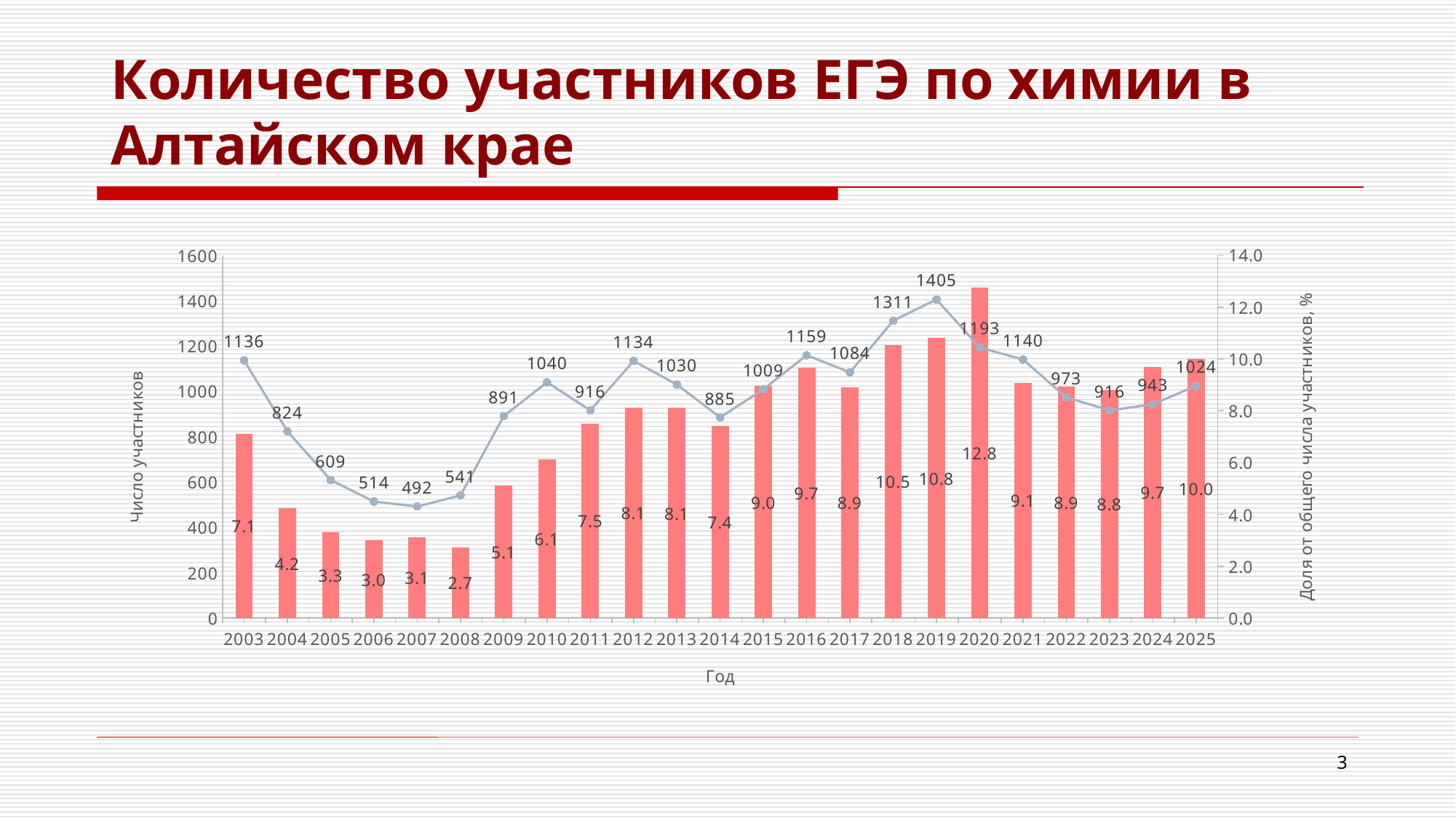
What is the number of participants shown for 2003? 1136 Does the number of participants rise or fall from 2003 to 2007? Fall Which year has the lowest share of the total number of participants? 2008 How many years are shown on the x axis of the chart? 23 Which year had more participants, 2012 or 2013? 2012 How many participants took the chemistry exam in 2019 according to the chart? 1405 Which year has the lowest number of participants? 2007 What kind of chart is shown on the slide? Combined bar and line chart What share of the total number of participants (%) is shown for 2020? 12.8 Which year has the highest number of participants? 2019 What is the difference between the number of participants in 2019 and in 2020? 212 What is the label of the x axis of the chart? Год